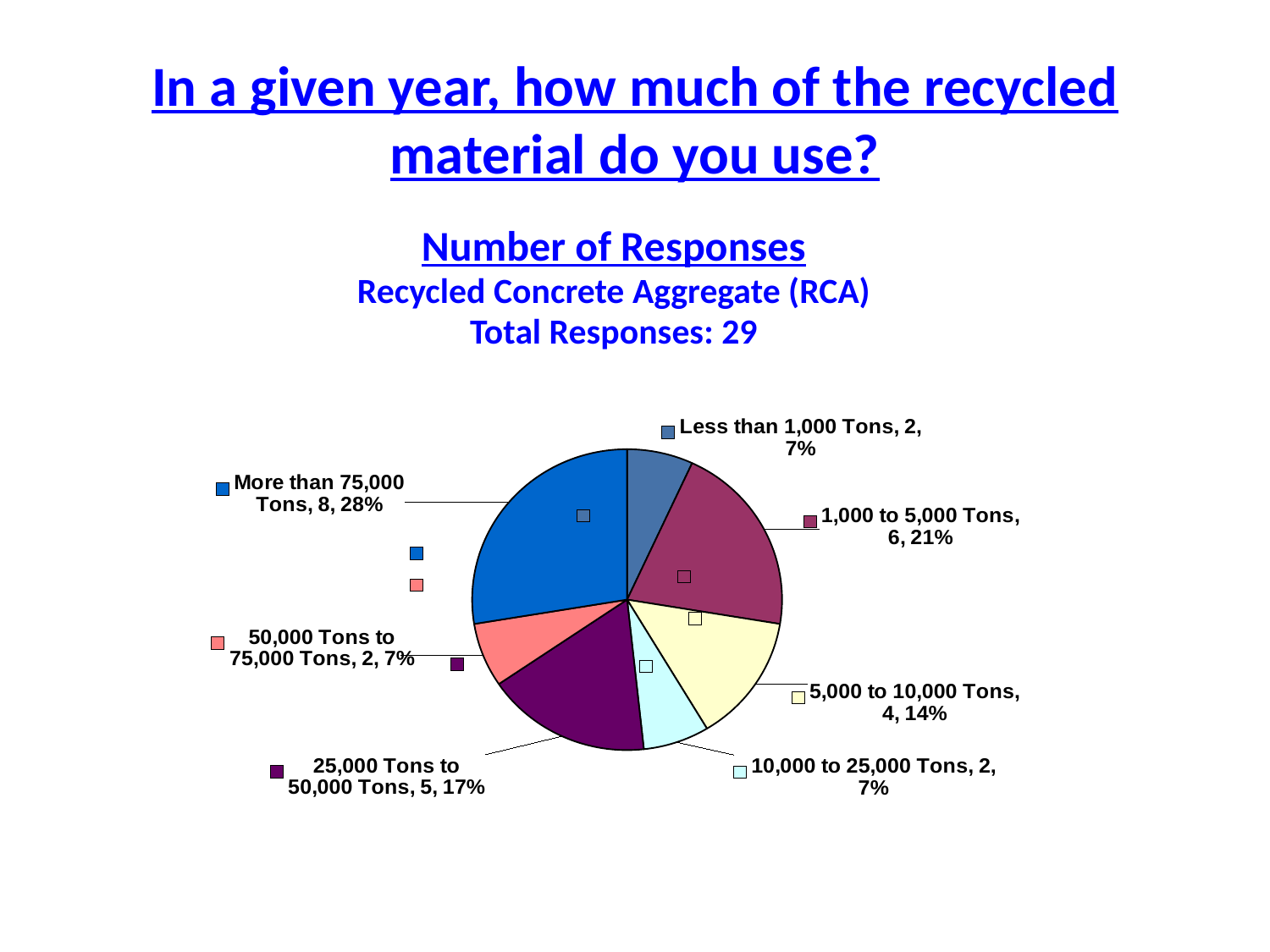
How many responses are in the '25,000 Tons to 50,000 Tons' category? 5 How many responses are in the 'Less than 1,000 Tons' category? 2 How many responses are in the 'More than 75,000 Tons' category? 8 What is the difference in responses between 'More than 75,000 Tons' and '1,000 to 5,000 Tons'? 2 What share of the pie does '5,000 to 10,000 Tons' represent? 14% What is the total number of responses stated on the slide? 29 What kind of chart is shown on the slide? Pie chart What percentage of responses fall in the '1,000 to 5,000 Tons' category? 21% How many categories are shown in the pie chart? 7 Which category has the largest number of responses? More than 75,000 Tons Which has more responses: '5,000 to 10,000 Tons' or '25,000 Tons to 50,000 Tons'? 25,000 Tons to 50,000 Tons Which recycled material does the chart cover? Recycled Concrete Aggregate (RCA)